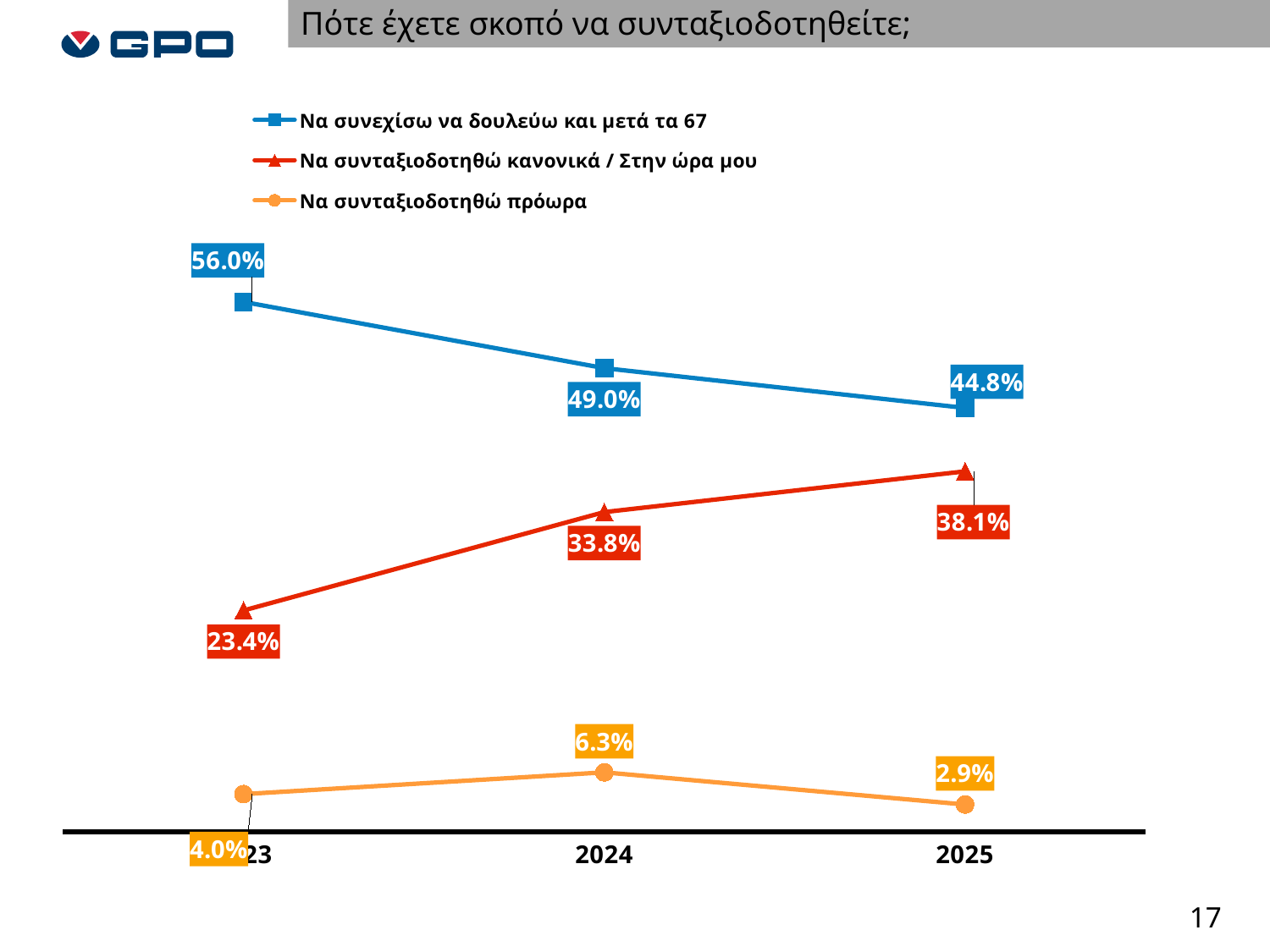
What is the value for 'Να συνταξιοδοτηθώ πρόωρα' in 2025? 2.9% In which year is 'Να συνεχίσω να δουλεύω και μετά τα 67' lowest? 2025 What type of chart is shown on the slide? line chart In which year is 'Να συνταξιοδοτηθώ πρόωρα' highest? 2024 Does 'Να συνταξιοδοτηθώ κανονικά / Στην ώρα μου' rise or fall from 2023 to 2025? rise What is the value for 'Να συνταξιοδοτηθώ κανονικά / Στην ώρα μου' in 2024? 33.8% What colour is the line for 'Να συνταξιοδοτηθώ πρόωρα'? orange What is the difference between 'Να συνεχίσω να δουλεύω και μετά τα 67' and 'Να συνταξιοδοτηθώ κανονικά / Στην ώρα μου' in 2025? 6.7% How many years are shown on the x axis? 3 What is the value for 'Να συνεχίσω να δουλεύω και μετά τα 67' in 2025? 44.8% Which is larger in 2024: 'Να συνεχίσω να δουλεύω και μετά τα 67' or 'Να συνταξιοδοτηθώ κανονικά / Στην ώρα μου'? Να συνεχίσω να δουλεύω και μετά τα 67 How many series does the legend list? 3